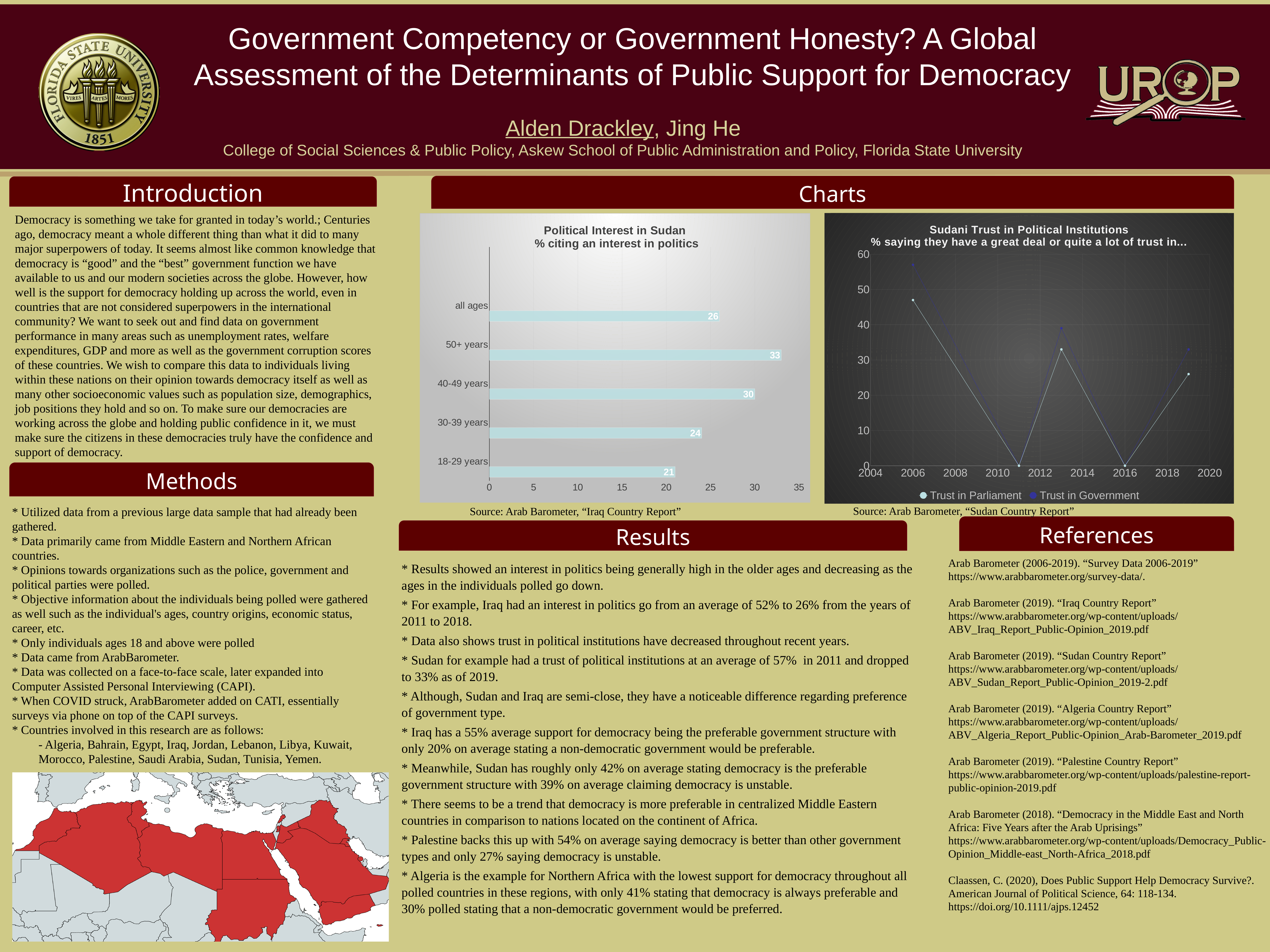
In the 'Political Interest in Sudan' chart, which age group has the lowest value? 18-29 years In the 'Political Interest in Sudan' chart, what is the value for 50+ years? 33 In the 'Political Interest in Sudan' chart, which age group has the highest value? 50+ years What kind of chart is 'Political Interest in Sudan'? bar chart How many series does the legend of the 'Sudani Trust in Political Institutions' chart list? 2 In the 'Political Interest in Sudan' chart, what is the value for all ages? 26 In the 'Sudani Trust in Political Institutions' chart, is the value for Trust in Parliament in 2006 greater or less than 40? greater In the 'Political Interest in Sudan' chart, what is the difference between the values for 40-49 years and 30-39 years? 6 How many bars are shown in the 'Political Interest in Sudan' chart? 5 In the 'Political Interest in Sudan' chart, what is the value for 18-29 years? 21 In the 'Political Interest in Sudan' chart, which is larger, the value for 30-39 years or the value for all ages? all ages What kind of chart is 'Sudani Trust in Political Institutions'? line chart